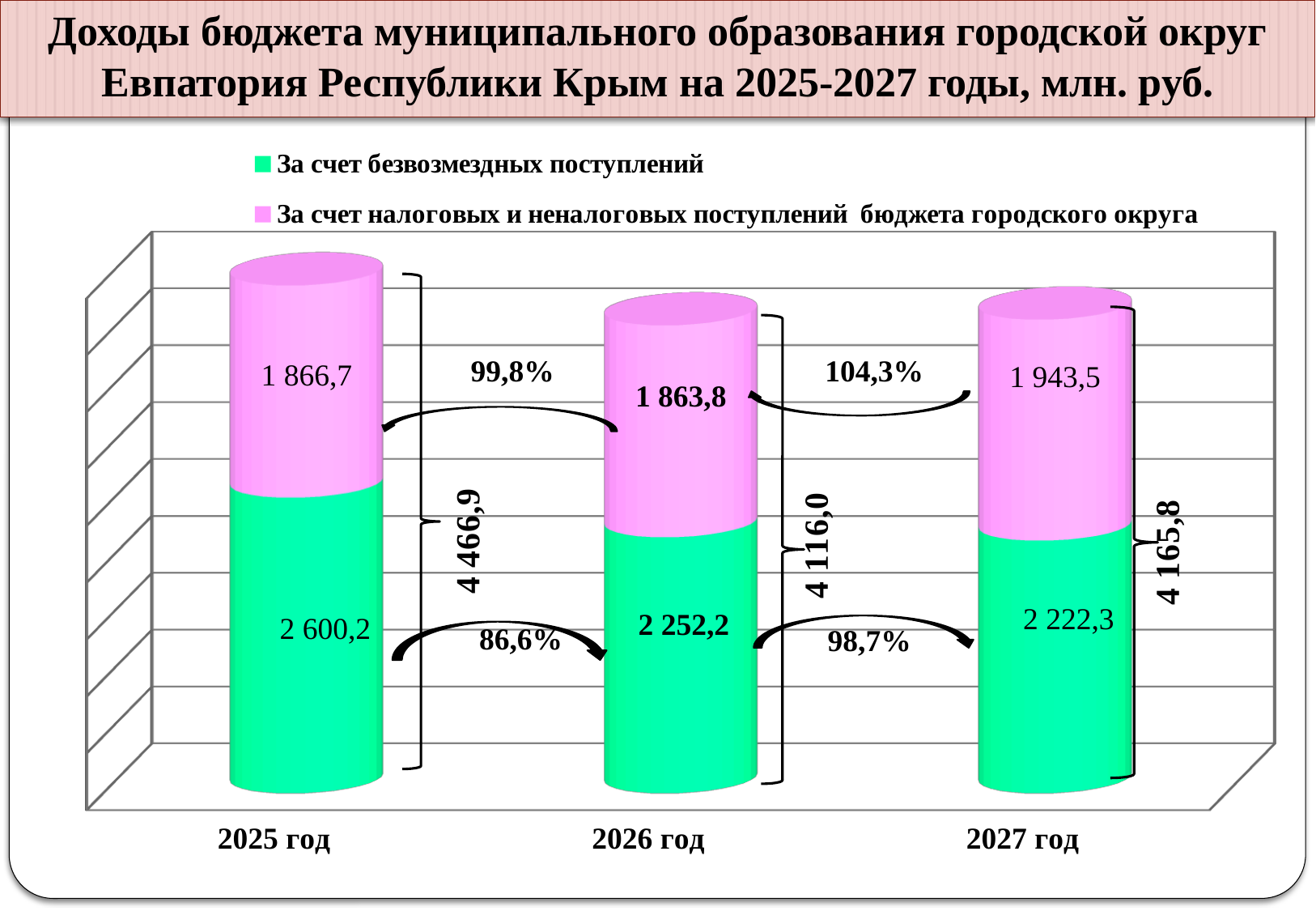
What is the value for 'За счет налоговых и неналоговых поступлений бюджета городского округа' in 2027 год? 1 943,5 How many series does the legend list? 2 In which year is the total budget income the highest? 2025 год What kind of chart is shown on the slide? Stacked bar chart In which year is the value for 'За счет безвозмездных поступлений' the lowest? 2027 год Which is larger in 2027 год: 'За счет безвозмездных поступлений' or 'За счет налоговых и неналоговых поступлений бюджета городского округа'? За счет безвозмездных поступлений What is the value for 'За счет безвозмездных поступлений' in 2025 год? 2 600,2 What is the difference between the 'За счет безвозмездных поступлений' values for 2025 год and 2026 год? 348,0 What is the total of the stacked bar for 2027 год? 4 165,8 How many years are shown on the x axis of the chart? 3 What is the value for 'За счет налоговых и неналоговых поступлений бюджета городского округа' in 2026 год? 1 863,8 What is the total of the stacked bar for 2026 год? 4 116,0